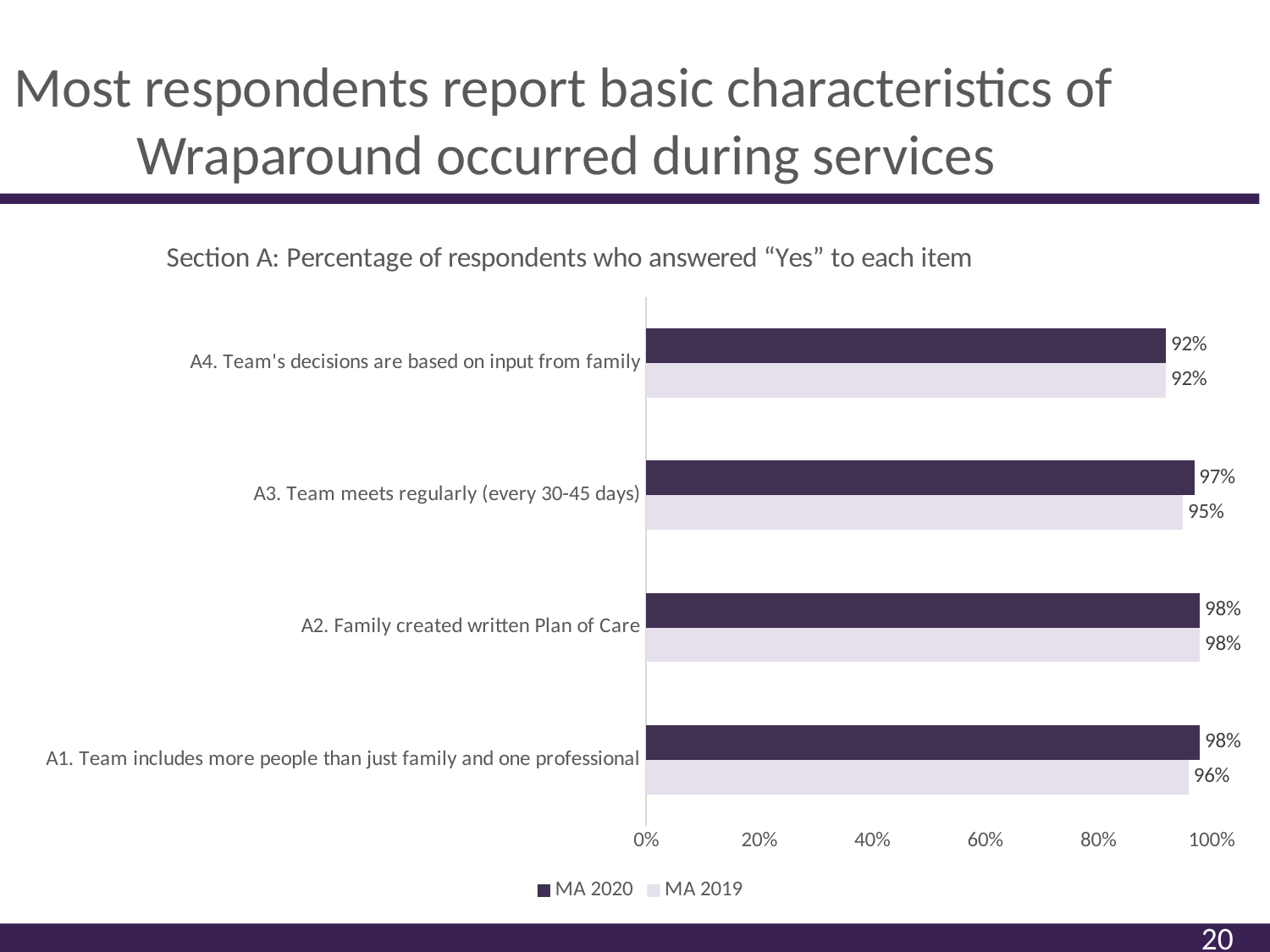
How many items are shown on the chart? 4 What percentage of MA 2019 respondents answered "Yes" to A1. Team includes more people than just family and one professional? 96% What is the difference between the MA 2020 and MA 2019 values for A3. Team meets regularly (every 30-45 days)? 2% What is the MA 2019 value for A4. Team's decisions are based on input from family? 92% What kind of chart is shown on the slide? Bar chart Is the MA 2019 value for A4. Team's decisions are based on input from family greater or less than 80%? greater What is the title of the chart? Section A: Percentage of respondents who answered "Yes" to each item What percentage of MA 2020 respondents answered "Yes" to A3. Team meets regularly (every 30-45 days)? 97% For A3. Team meets regularly (every 30-45 days), which series has the larger value, MA 2020 or MA 2019? MA 2020 What is the difference between the MA 2020 and MA 2019 values for A1. Team includes more people than just family and one professional? 2% How many series does the legend list? 2 Which item has the lowest MA 2020 value? A4. Team's decisions are based on input from family